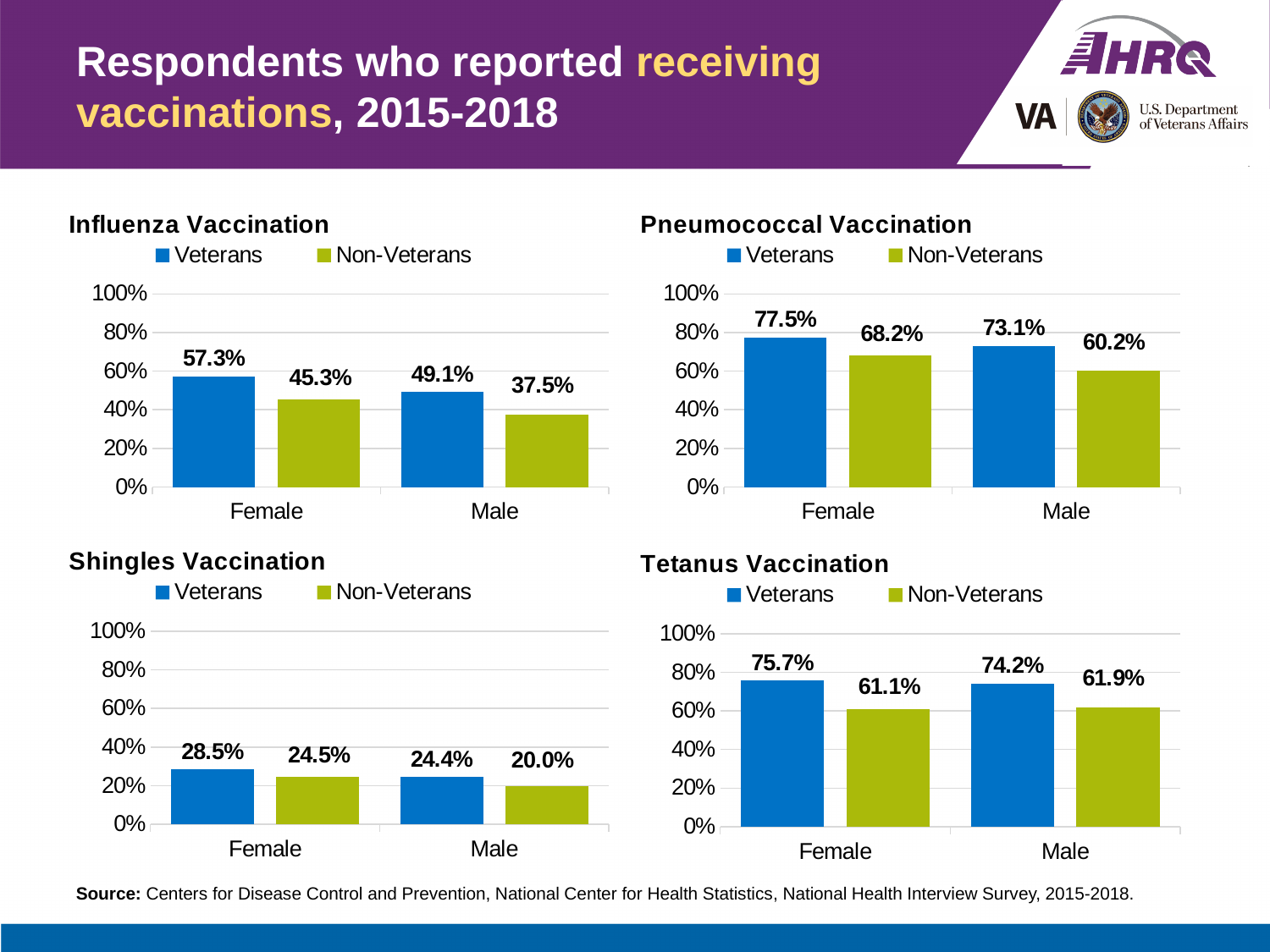
In the Influenza Vaccination chart, is the value for male Non-Veterans greater or less than 40%? less In the Influenza Vaccination chart, what is the difference between female Veterans and female Non-Veterans? 12.0% In the Shingles Vaccination chart, what is the value for male Non-Veterans? 20.0% In the Influenza Vaccination chart, what percentage of female Veterans reported receiving the vaccination? 57.3% In the Tetanus Vaccination chart, what is the value for female Non-Veterans? 61.1% In the Tetanus Vaccination chart, which is larger: the value for male Veterans or male Non-Veterans? Male Veterans In the Pneumococcal Vaccination chart, which bar has the highest value? Female Veterans What kind of chart is the Tetanus Vaccination chart? Bar chart How many series does the legend of the Shingles Vaccination chart list? 2 How many charts are shown on the slide? 4 In the Pneumococcal Vaccination chart, what is the value for male Non-Veterans? 60.2% In the Shingles Vaccination chart, which bar has the lowest value? Male Non-Veterans